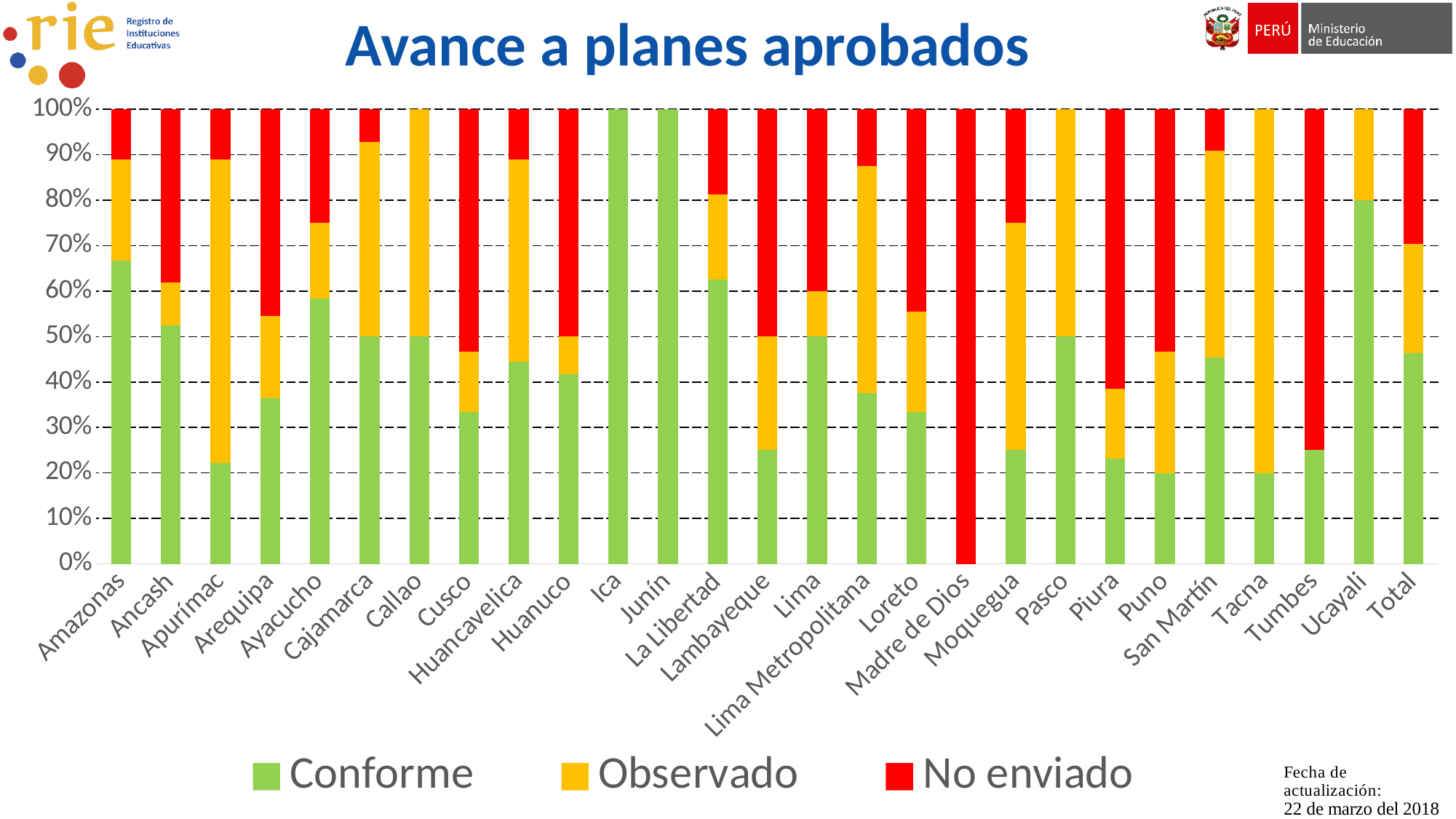
How many series does the legend list? 3 Is the Conforme share for Apurímac greater or less than 30%? less What is the Conforme share for Ica? 100% How many bars (categories) are plotted along the x axis, including Total? 27 Which category has the largest No enviado share? Madre de Dios What are the three series named in the legend? Conforme, Observado, No enviado Which has the larger Conforme share, Arequipa or Ayacucho? Ayacucho Is the Conforme share for Total greater or less than 50%? less What kind of chart is shown on the slide? Stacked bar chart Is the Conforme share for Amazonas greater or less than 60%? greater What is the No enviado share for Madre de Dios? 100% Which category has no Conforme segment at all? Madre de Dios